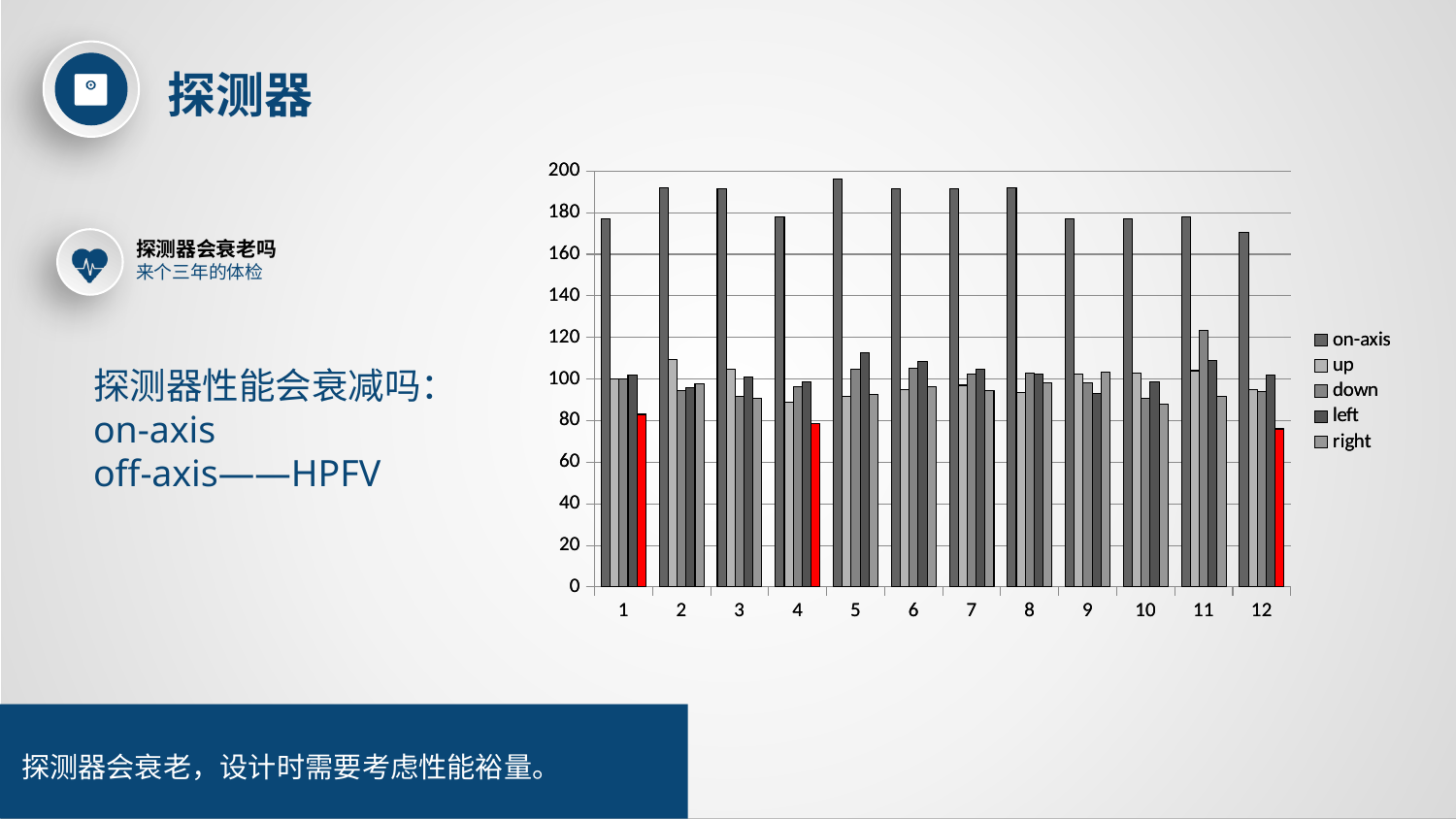
What are the series names listed in the chart's legend? on-axis, up, down, left, right Which is larger, the on-axis value for category 5 or the on-axis value for category 12? category 5 Which is larger, the right value for category 1 or the right value for category 2? category 2 Is the on-axis value for category 5 greater or less than 180? greater Is the down value for category 11 greater or less than 100? greater Is the on-axis value for category 12 greater or less than 180? less What kind of chart is shown on the slide? bar chart Which series is drawn with the tallest bars in every category? on-axis How many series does the chart's legend list? 5 How many categories are shown along the x axis of the chart? 12